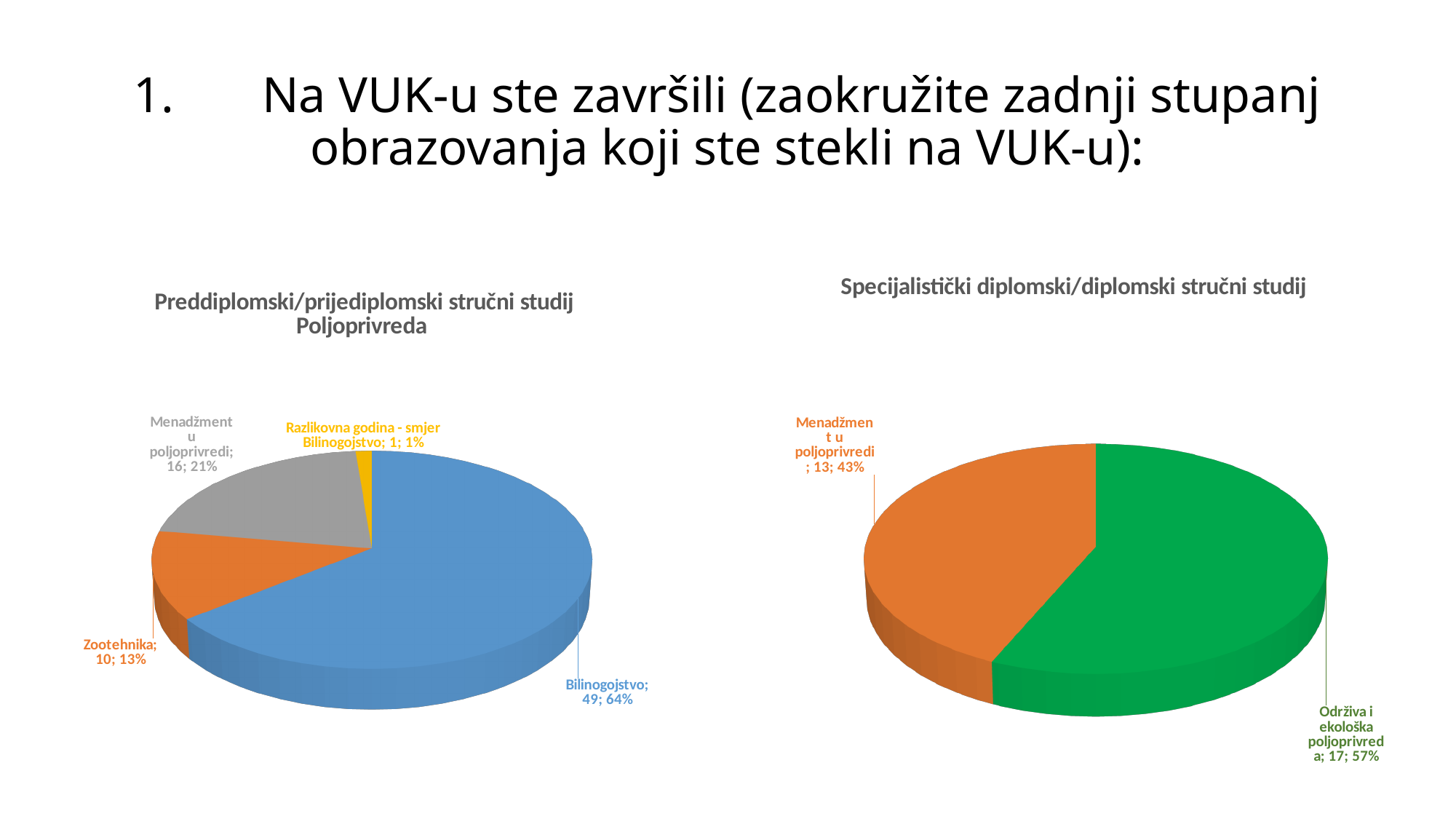
In the left chart (Preddiplomski/prijediplomski stručni studij Poljoprivreda), which category has the smallest slice? Razlikovna godina - smjer Bilinogojstvo What type of chart is the right chart (Specijalistički diplomski/diplomski stručni studij)? Pie chart In the right chart (Specijalistički diplomski/diplomski stručni studij), what share of the pie is Menadžment u poljoprivredi? 43% In the right chart (Specijalistički diplomski/diplomski stručni studij), what is the value for Održiva i ekološka poljoprivreda? 17 In the left chart (Preddiplomski/prijediplomski stručni studij Poljoprivreda), which category has the largest slice? Bilinogojstvo In the right chart (Specijalistički diplomski/diplomski stručni studij), how many categories are shown? 2 In the left chart (Preddiplomski/prijediplomski stručni studij Poljoprivreda), what is the value for Bilinogojstvo? 49 In the left chart (Preddiplomski/prijediplomski stručni studij Poljoprivreda), what share of the pie is Zootehnika? 13% In the left chart (Preddiplomski/prijediplomski stručni studij Poljoprivreda), what is the total of all slices? 76 In the left chart (Preddiplomski/prijediplomski stručni studij Poljoprivreda), how many categories are shown? 4 In the right chart (Specijalistički diplomski/diplomski stručni studij), which is larger: Menadžment u poljoprivredi or Održiva i ekološka poljoprivreda? Održiva i ekološka poljoprivreda In the left chart (Preddiplomski/prijediplomski stručni studij Poljoprivreda), what is the difference between the values for Menadžment u poljoprivredi and Zootehnika? 6